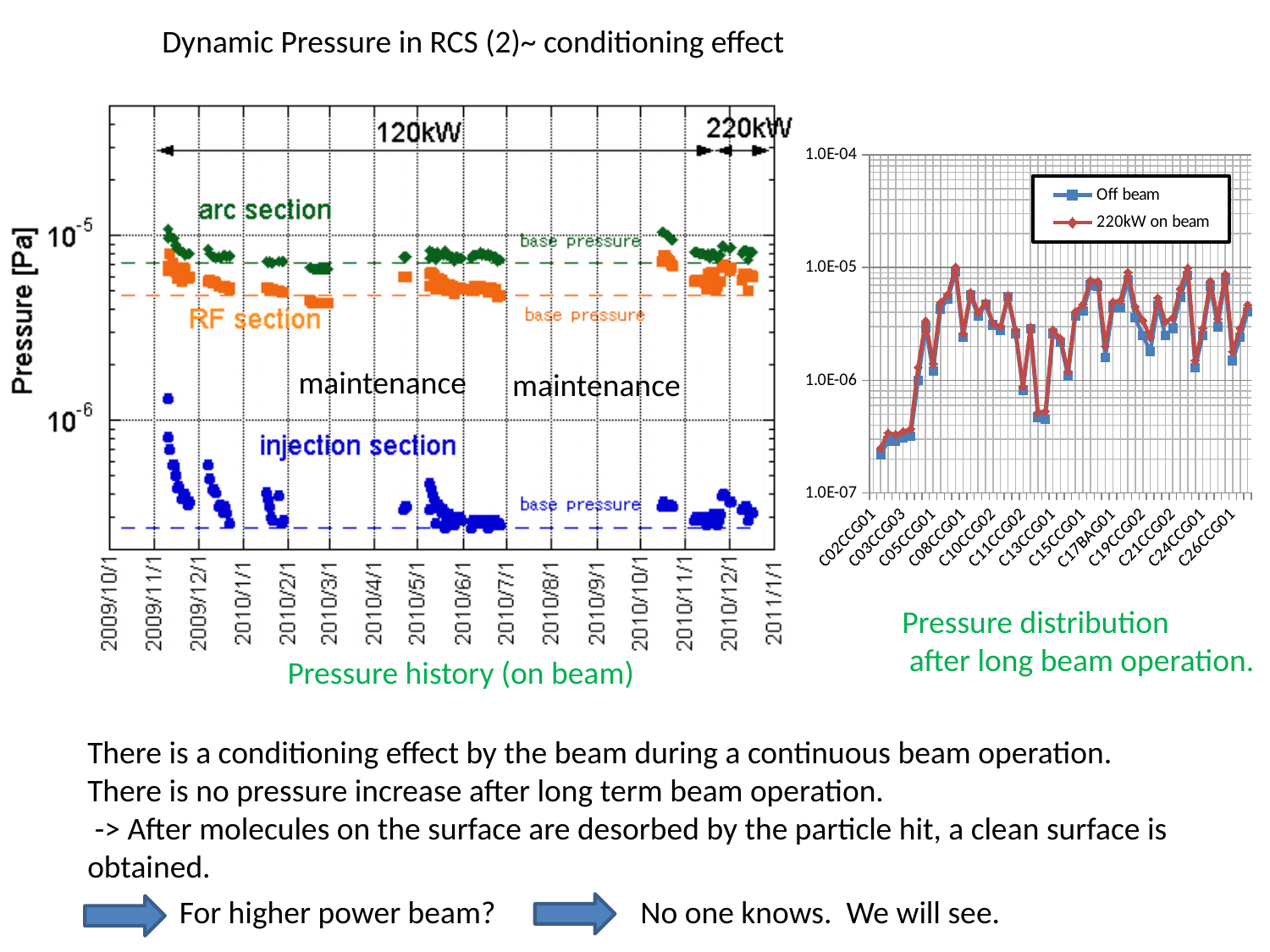
On the right chart (Pressure distribution after long beam operation), how many series does the legend list? 2 On the left chart (Pressure history on beam), which section has the lowest pressure? injection section On the left chart (Pressure history on beam), how many sections are plotted? 3 On the left chart (Pressure history on beam), which section is higher in pressure, the RF section or the injection section? RF section On the right chart, is the 220kW on beam value for C13CCG01 greater or less than 1.0E-06? less On the right chart, which series generally lies higher, Off beam or 220kW on beam? 220kW on beam On the left chart (Pressure history on beam), which section has the highest pressure? arc section On the right chart, what is the lowest value shown on the vertical axis? 1.0E-07 What kind of chart is the right chart (Pressure distribution after long beam operation)? Line chart On the right chart, is the Off beam value for C02CCG01 greater or less than 1.0E-06? less On the right chart (Pressure distribution after long beam operation), what are the two series named in the legend? Off beam and 220kW on beam On the left chart (Pressure history on beam), is the pressure of the arc section greater or less than 10^-6 Pa? greater